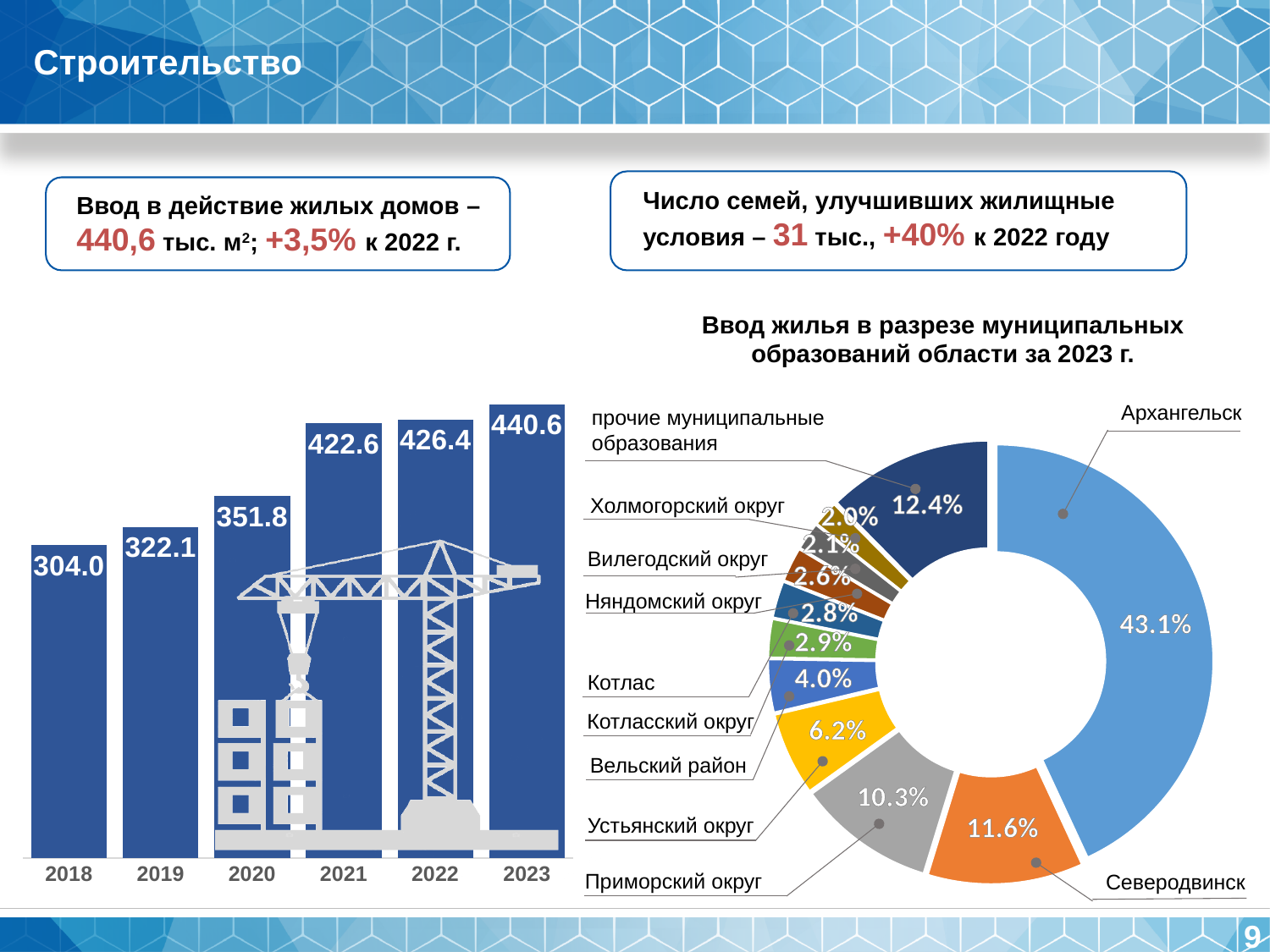
On the bar chart on the left, how many years are shown? 6 On the chart 'Ввод жилья в разрезе муниципальных образований области за 2023 г.', which is larger, Приморский округ or Устьянский округ? Приморский округ What kind of chart is the chart on the left? bar chart On the bar chart on the left, do the values rise or fall from 2018 to 2023? rise On the bar chart on the left, what is the value for 2021? 422.6 On the bar chart on the left, what is the value for 2018? 304.0 On the chart 'Ввод жилья в разрезе муниципальных образований области за 2023 г.', what share does Архангельск have? 43.1% On the bar chart on the left, which year has the highest value? 2023 On the chart 'Ввод жилья в разрезе муниципальных образований области за 2023 г.', what share does Северодвинск have? 11.6% On the bar chart on the left, which year has the lowest value? 2018 On the chart 'Ввод жилья в разрезе муниципальных образований области за 2023 г.', what is the difference between the shares of Вельский район and Котлас? 1.2% On the bar chart on the left, what is the difference between the values for 2023 and 2022? 14.2